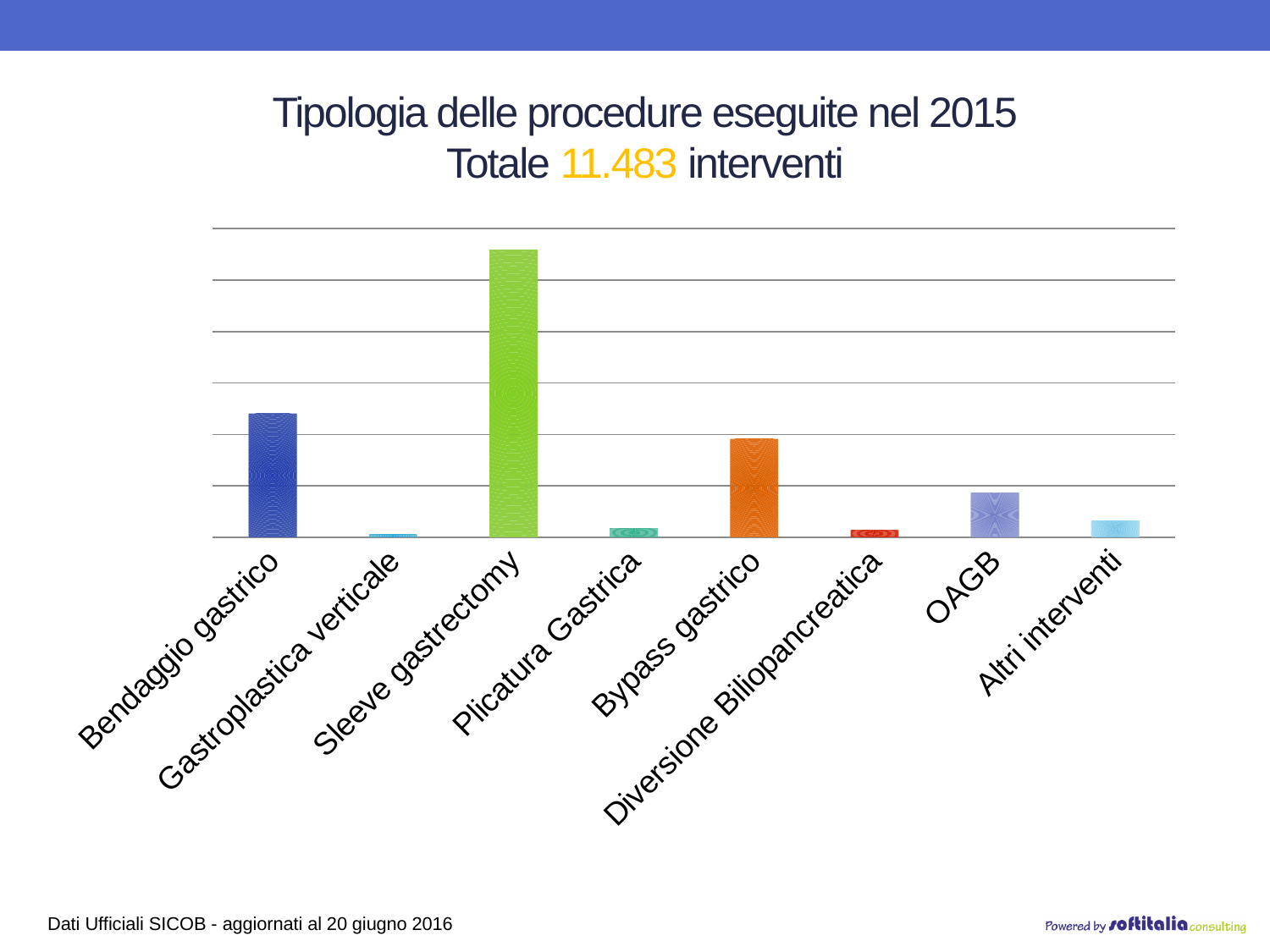
Which procedure has the lowest bar in the chart? Gastroplastica verticale Which year do the procedures in the chart refer to, according to the title? 2015 Which procedure has the highest bar in the chart? Sleeve gastrectomy Which bar is taller, Bypass gastrico or OAGB? Bypass gastrico Which bar is taller, OAGB or Altri interventi? OAGB Which bar is taller, Sleeve gastrectomy or Bendaggio gastrico? Sleeve gastrectomy Which procedure has the second-highest bar in the chart? Bendaggio gastrico What kind of chart is shown on the slide? bar chart According to the slide title, what is the total number of interventions performed in 2015? 11.483 How many procedure categories are shown on the x axis of the chart? 8